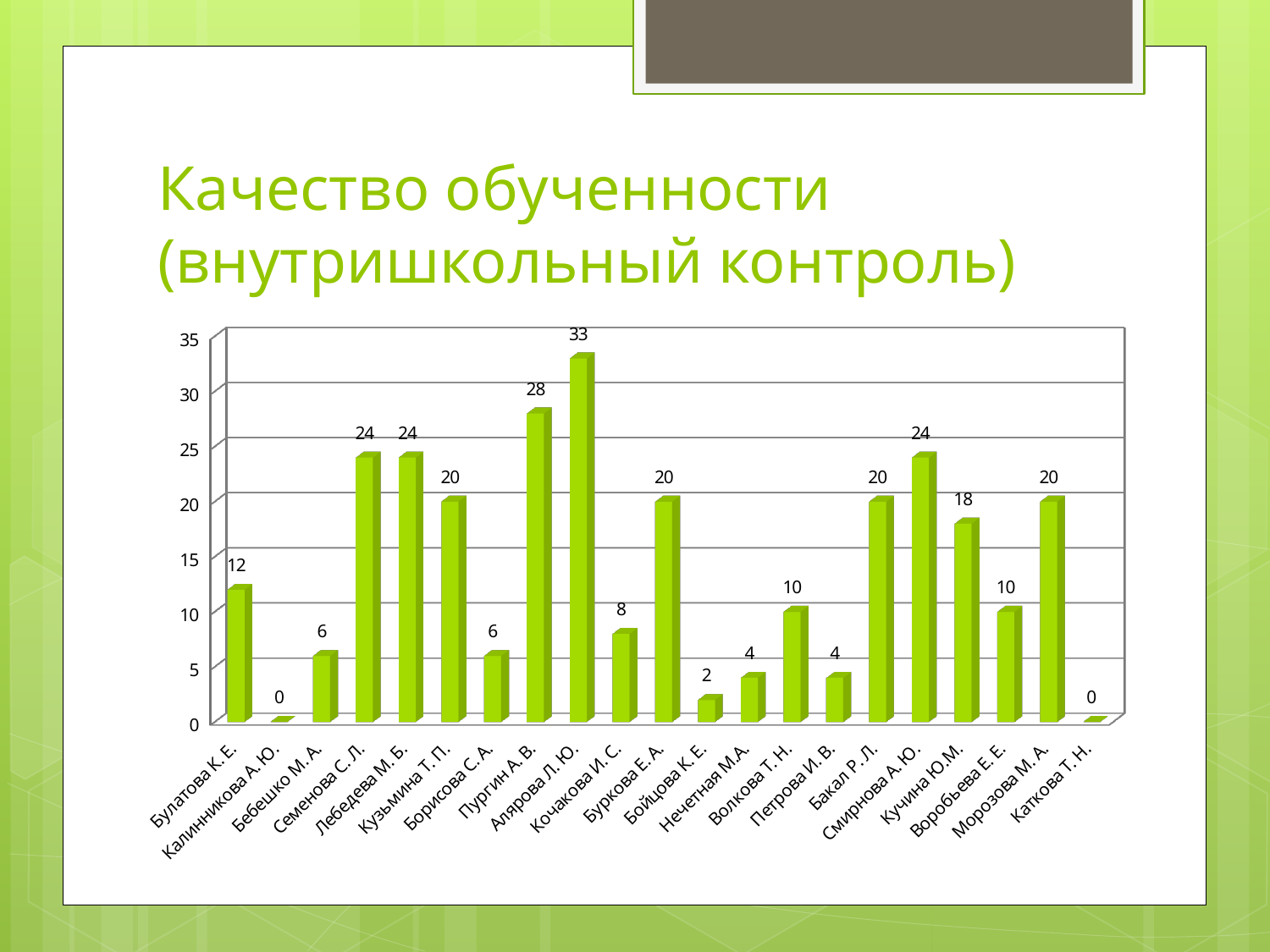
Which category has the highest value? Алярова Л. Ю. What is the value for Бойцова К. Е.? 2 What is the value for Пургин А. В.? 28 What is the lowest value shown in the chart? 0 What is the title of the slide? Качество обученности (внутришкольный контроль) What is the difference between the values for Семенова С. Л. and Булатова К. Е.? 12 How many categories are shown on the x axis? 21 What is the difference between the values for Алярова Л. Ю. and Пургин А. В.? 5 What is the value for Алярова Л. Ю.? 33 What kind of chart is shown on the slide? Bar chart What is the value for Кучина Ю.М.? 18 Which is larger, the value for Волкова Т. Н. or the value for Кочакова И. С.? Волкова Т. Н.